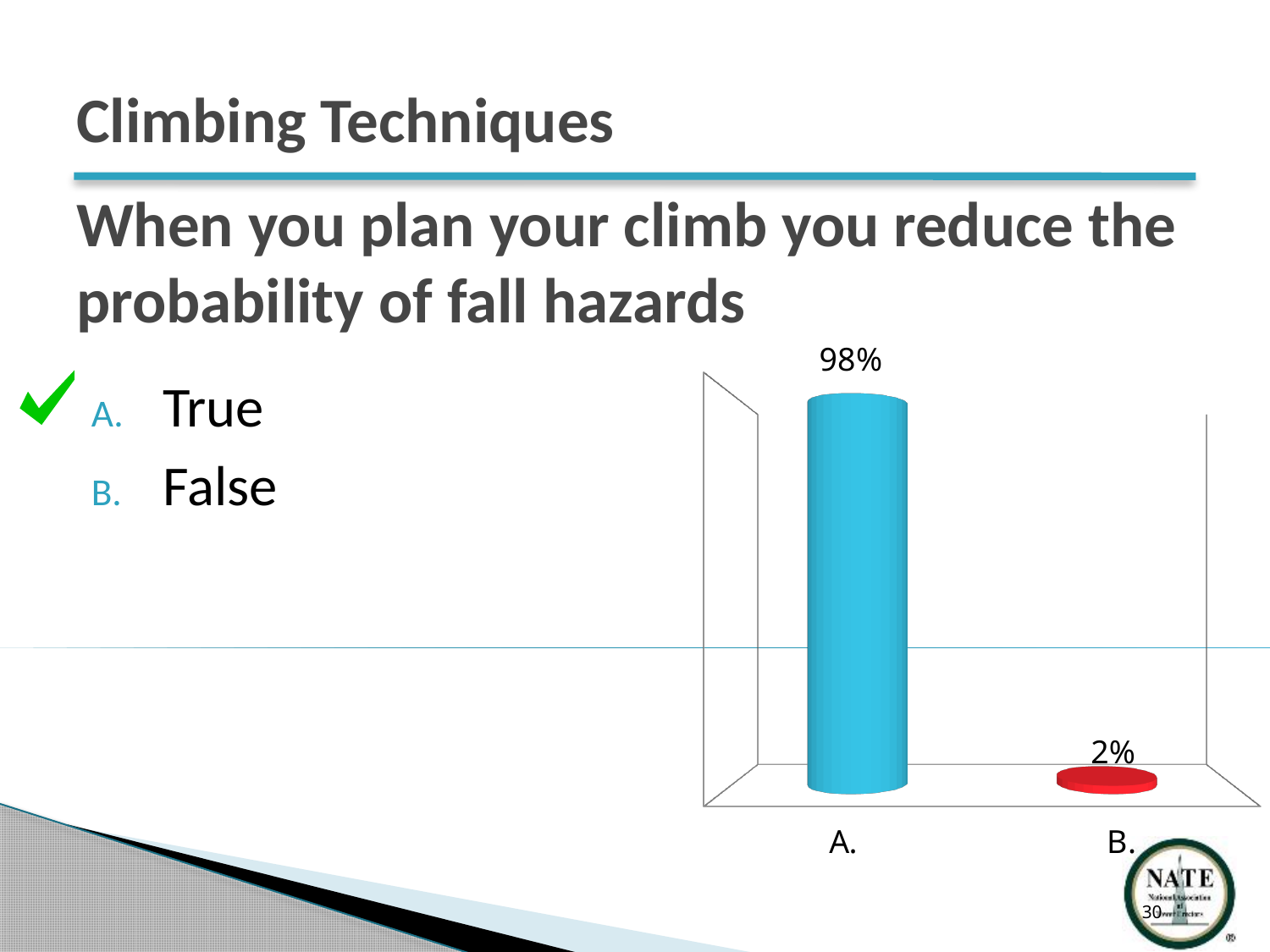
What is the total of the values for A. and B.? 100% Which is larger, the value for A. or the value for B.? A. Which category has the highest value? A. What colour is the bar for category A.? blue How many categories are plotted in the chart? 2 What is the value shown for category B.? 2% What kind of chart is shown on the slide? bar chart Which category has the lowest value? B. What is the difference between the values for A. and B.? 96% What is the value shown for category A.? 98% What colour is the bar for category B.? red